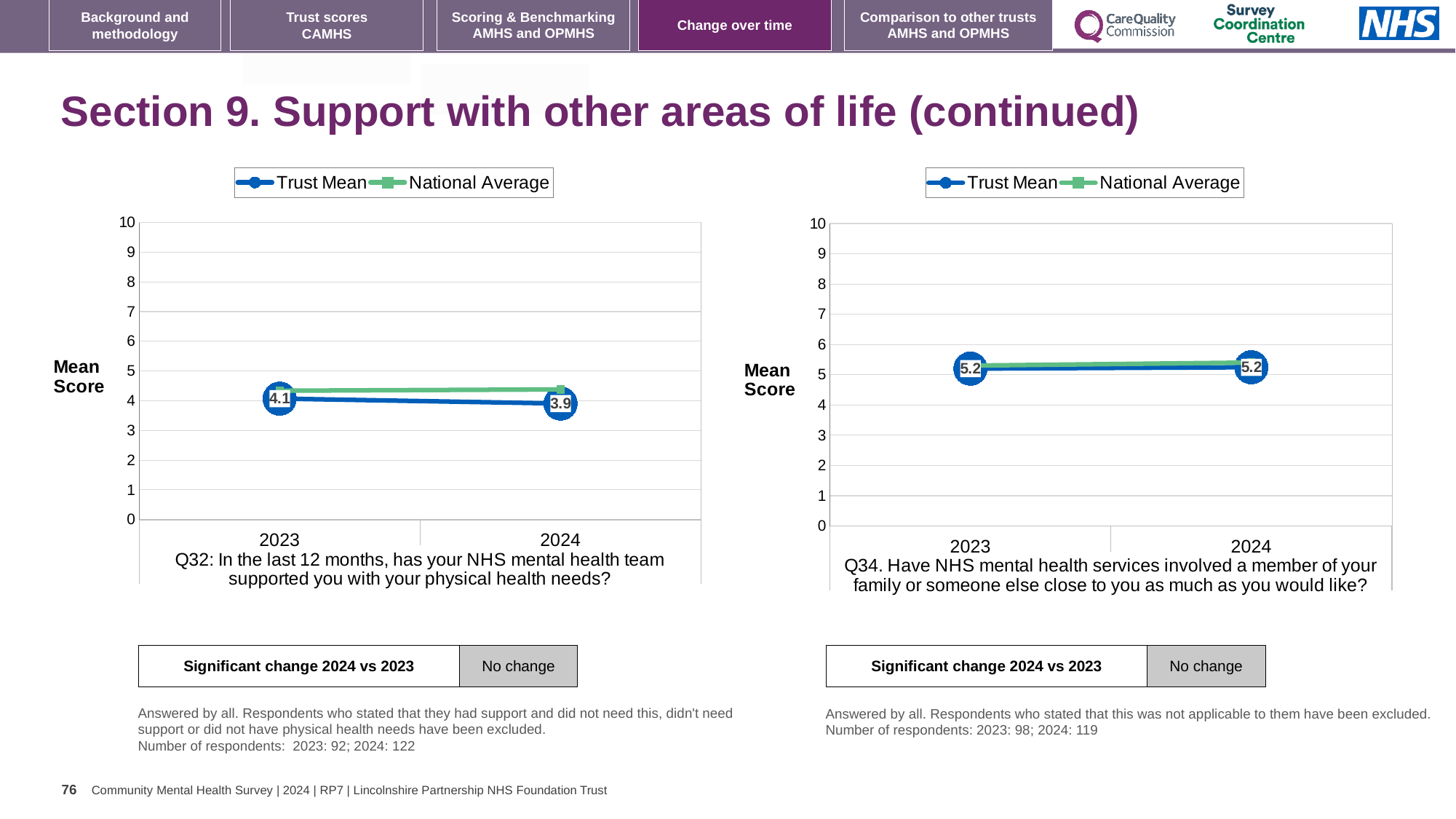
On the right chart (Q34), what is the Trust Mean for 2024? 5.2 On the left chart (Q32), which year has the higher Trust Mean, 2023 or 2024? 2023 On the right chart (Q34), is the National Average for 2023 greater or less than 5? greater How many years are shown on the x axis of the left chart (Q32)? 2 On the left chart (Q32), is the National Average for 2024 greater or less than 5? less On the left chart (Q32), does the Trust Mean rise or fall from 2023 to 2024? fall On the right chart (Q34), does the Trust Mean rise, fall or stay the same from 2023 to 2024? stay the same On the left chart (Q32), what is the Trust Mean for 2024? 3.9 How many series does the legend of the right chart (Q34) list? 2 On the left chart (Q32), what is the difference between the Trust Mean in 2023 and in 2024? 0.2 On the left chart (Q32), what is the Trust Mean for 2023? 4.1 What kind of chart is the right chart (Q34)? line chart